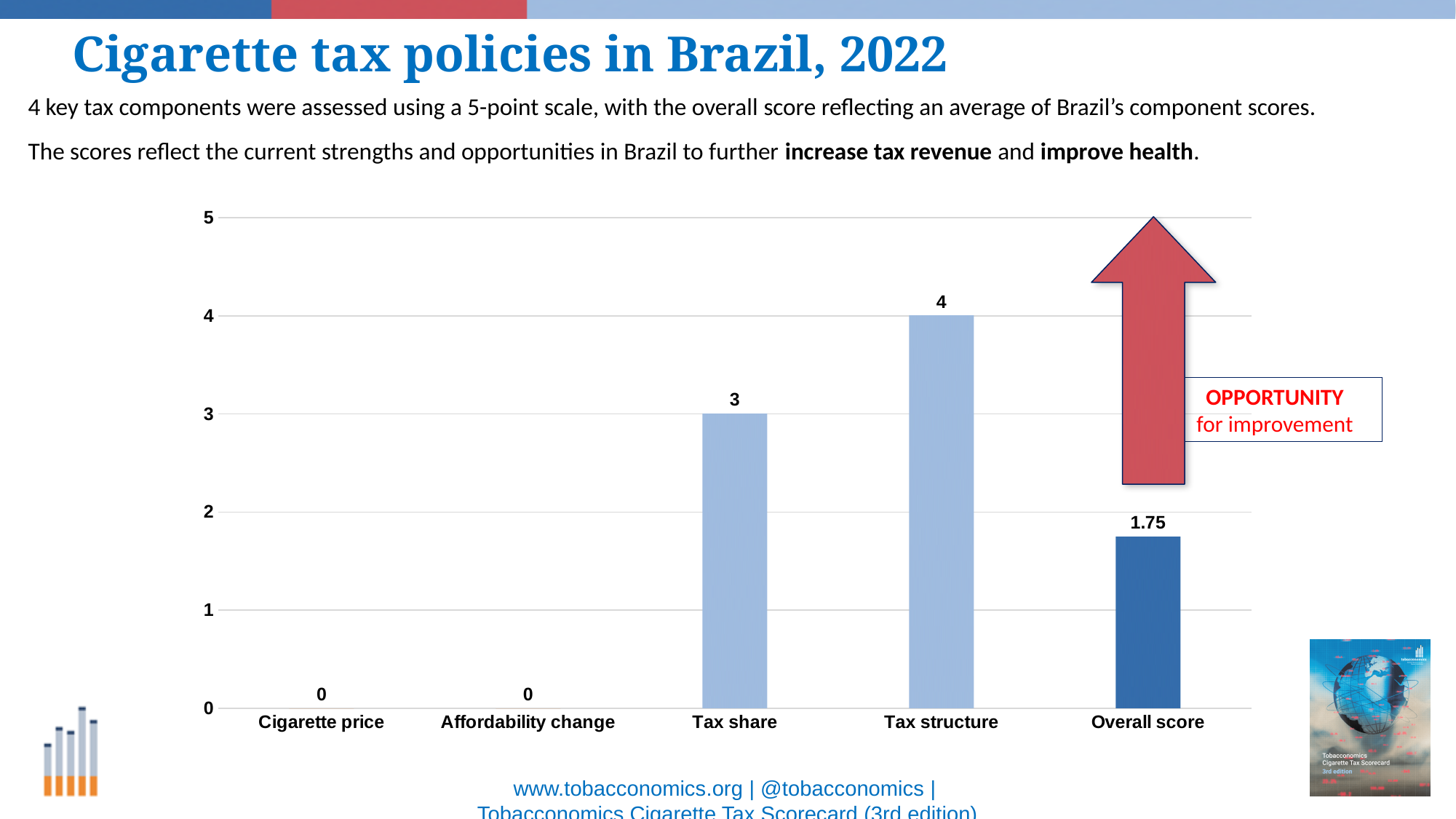
What is the highest value shown on the y axis? 5 What is the difference between the values for Tax share and Overall score? 1.25 Which category has the highest value? Tax structure What is the value for Tax structure? 4 What kind of chart is shown on the slide? bar chart How many categories are shown on the x axis? 5 Is the Overall score greater or less than 2? less What is the value for Tax share? 3 Which is larger, the value for Tax share or the Overall score? Tax share What is the value for Cigarette price? 0 What is the difference between the values for Tax structure and Tax share? 1 What is the Overall score? 1.75